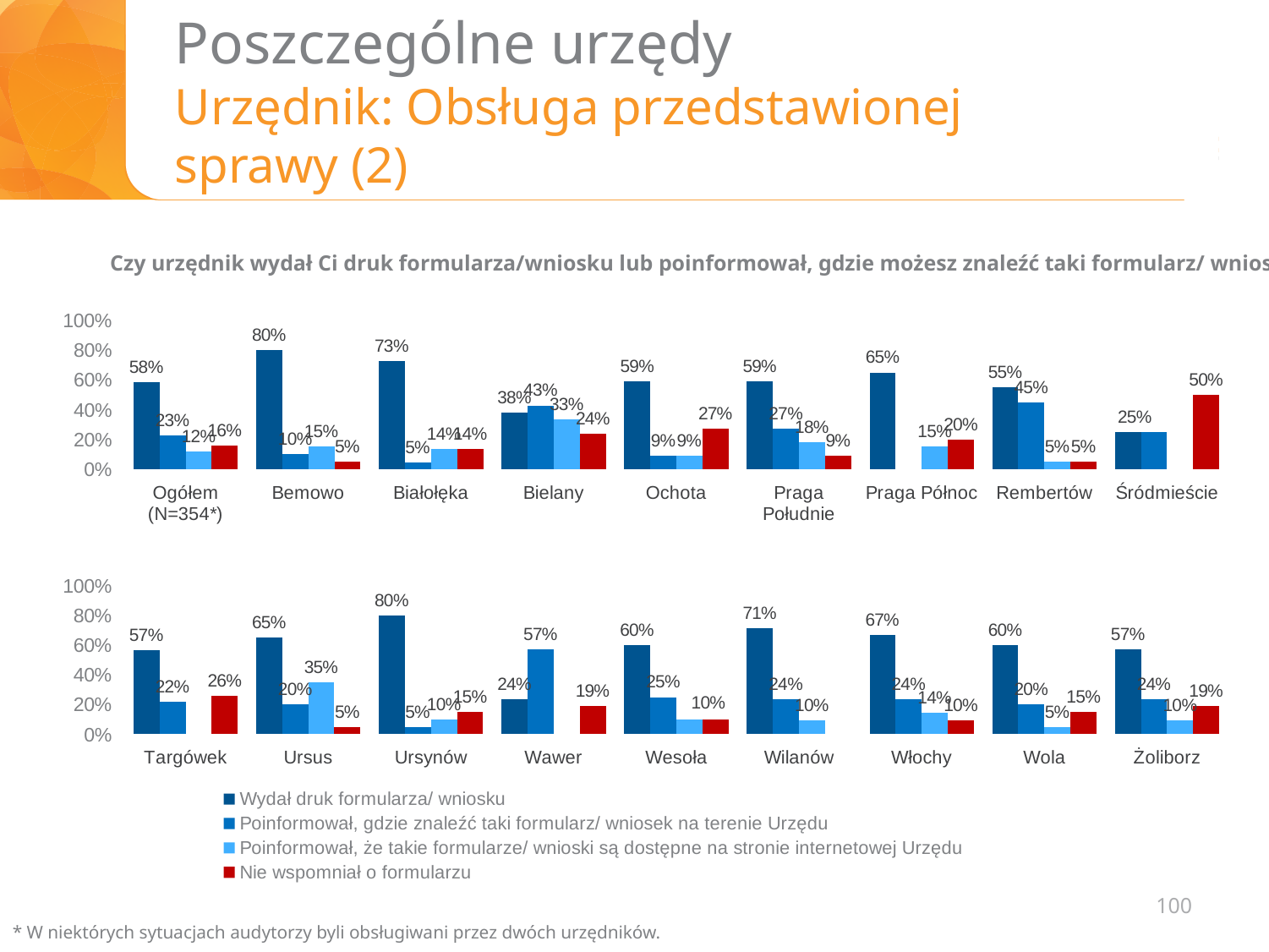
In the bottom chart, which is larger: the "Nie wspomniał o formularzu" value for Targówek or for Żoliborz? Targówek In the top chart, what is the value for "Wydał druk formularza/ wniosku" for Ogółem (N=354*)? 58% In the bottom chart, which district has the highest value for "Wydał druk formularza/ wniosku"? Ursynów In the bottom chart, what is the value for "Poinformował, gdzie znaleźć taki formularz/ wniosek na terenie Urzędu" for Wawer? 57% How many categories are shown on the x axis of the bottom chart? 9 What kind of chart is shown on the slide? Bar chart In the top chart, which district has the lowest value for "Wydał druk formularza/ wniosku"? Śródmieście How many series does the legend list? 4 In the bottom chart, what is the value for "Poinformował, że takie formularze/ wnioski są dostępne na stronie internetowej Urzędu" for Ursus? 35% In the top chart, which district has the highest value for "Nie wspomniał o formularzu"? Śródmieście In the top chart, what is the difference between the "Wydał druk formularza/ wniosku" values for Białołęka and Bielany? 35 percentage points In the top chart, what percentage of officials in Bemowo issued the form ("Wydał druk formularza/ wniosku")? 80%